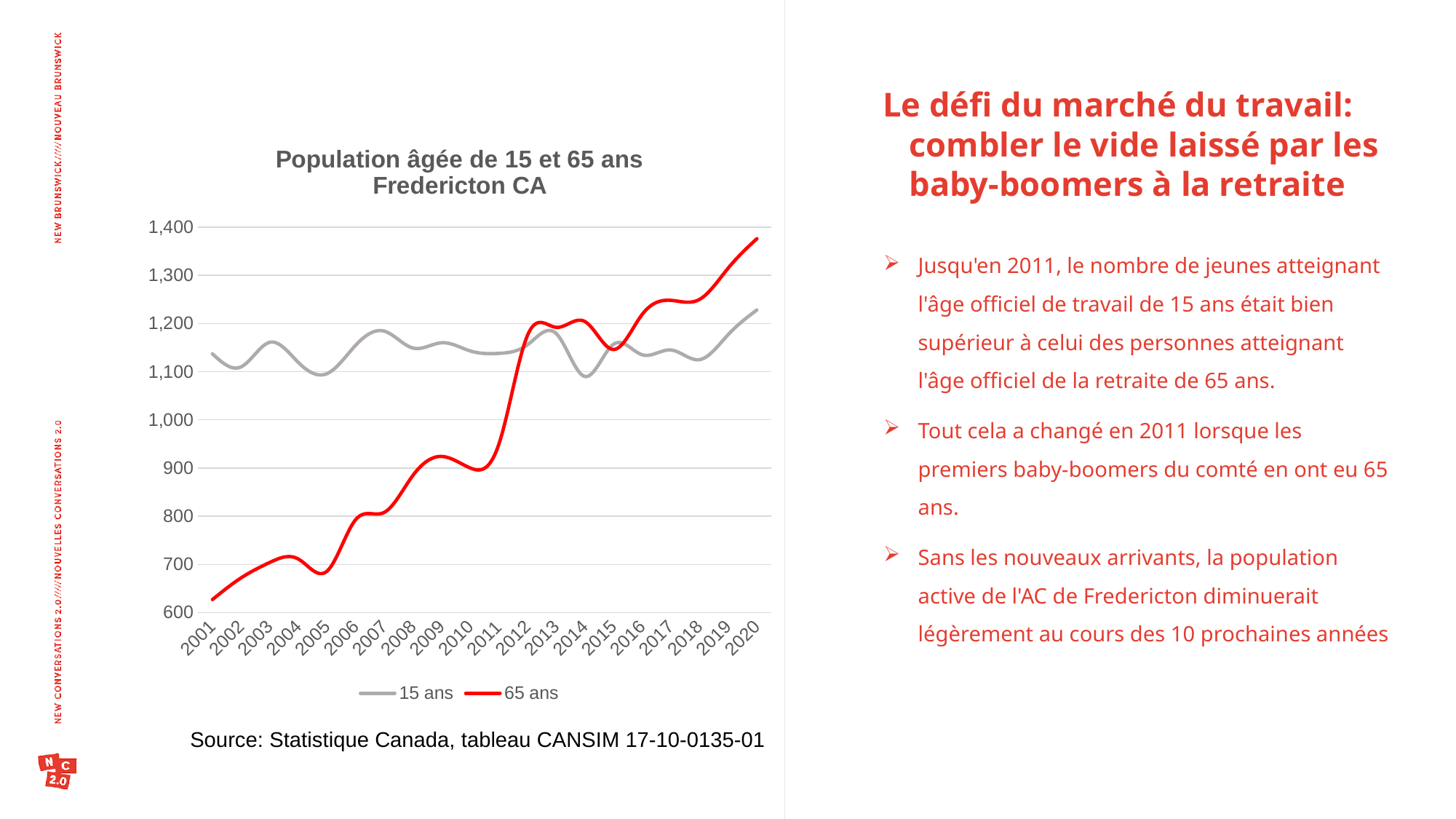
Is the value for 65 ans in 2017 greater or less than 1,200? greater Which colour is used for the 65 ans series? Red In 2020, which series has the larger value, 15 ans or 65 ans? 65 ans What kind of chart is shown on the slide? Line chart Does the 65 ans series generally rise or fall from 2001 to 2020? Rise How many years are shown on the x axis? 20 In 2001, which series has the larger value, 15 ans or 65 ans? 15 ans Is the value for 65 ans in 2001 greater or less than 700? less Is the value for 15 ans in 2001 greater or less than 1,100? greater What is the title of the chart? Population âgée de 15 et 65 ans Fredericton CA How many series does the legend list? 2